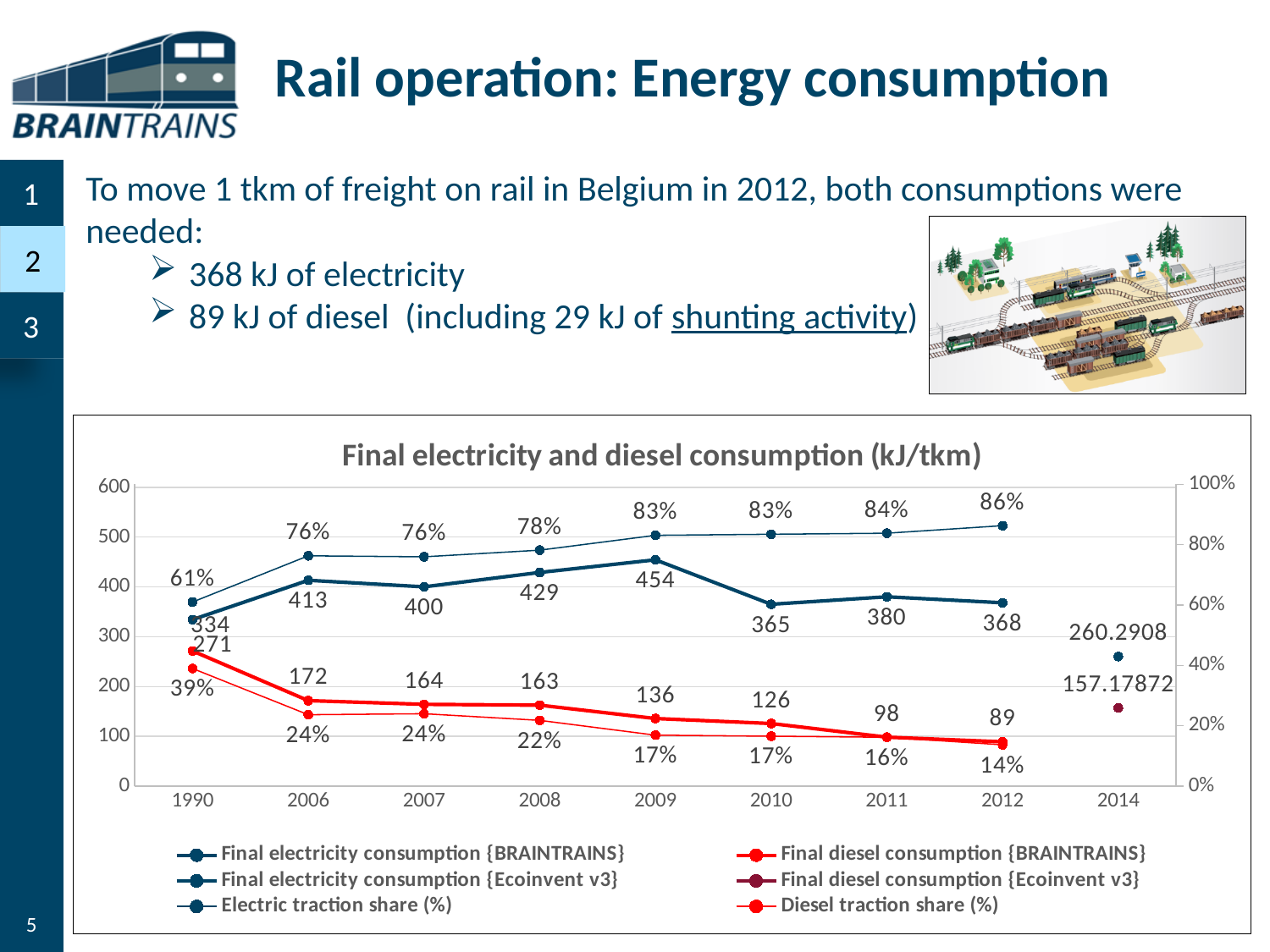
In which year is the Final electricity consumption {BRAINTRAINS} highest? 2009 What is the Electric traction share (%) for 2012? 86% In which year is the Final diesel consumption {BRAINTRAINS} lowest? 2012 How many years are shown on the x axis? 9 Does the Final diesel consumption {BRAINTRAINS} rise or fall from 1990 to 2012? fall What is the Diesel traction share (%) for 1990? 39% What is the Final diesel consumption {BRAINTRAINS} value for 2012? 89 What is the Final electricity consumption {BRAINTRAINS} value for 2009? 454 What is the difference between the Final electricity consumption {BRAINTRAINS} values for 2009 and 2010? 89 What is the Final electricity consumption {Ecoinvent v3} value shown for 2014? 260.2908 How many series does the legend list? 6 Which year has the larger Final diesel consumption {BRAINTRAINS} value, 1990 or 2006? 1990